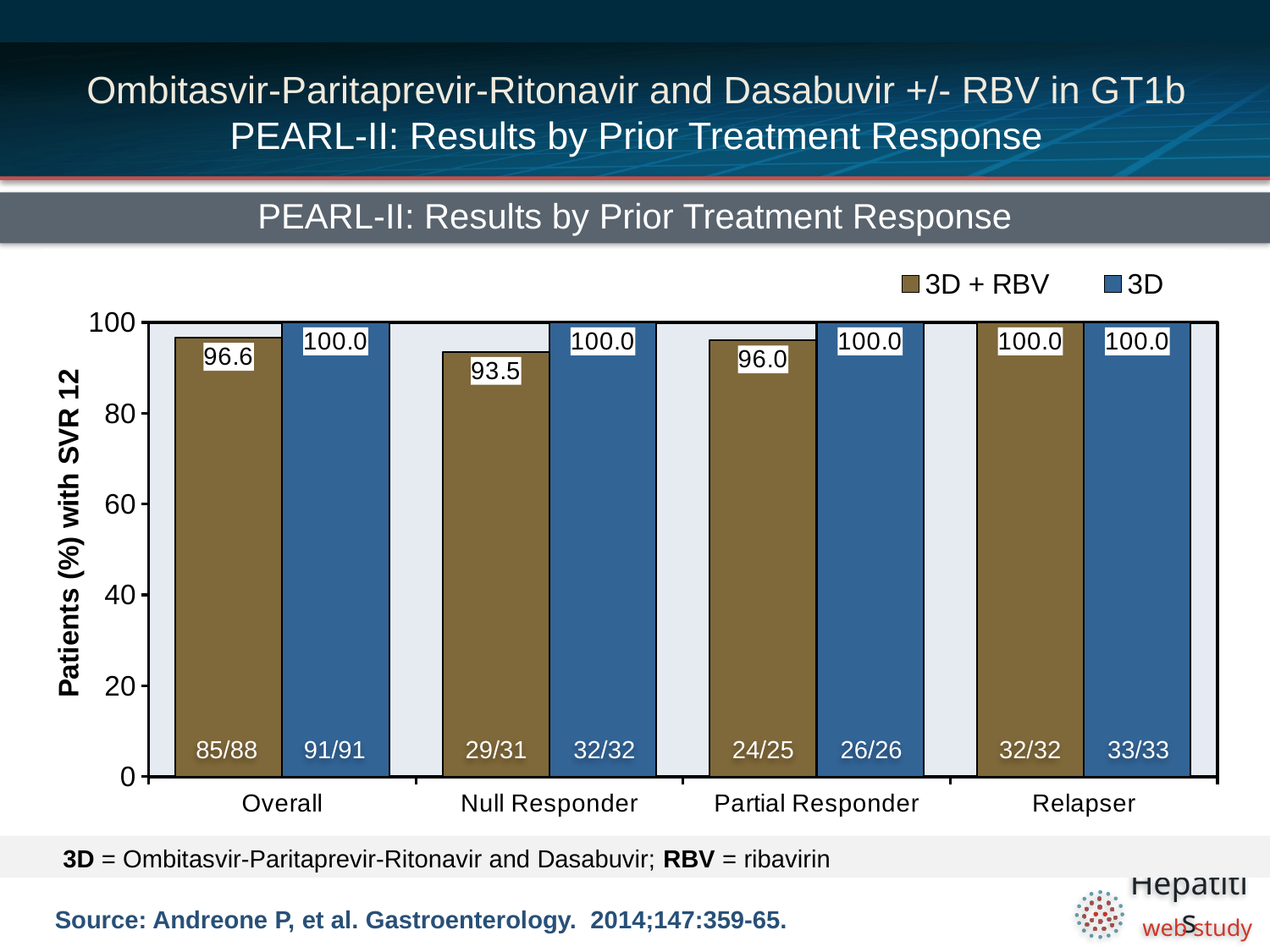
Which prior treatment response category has the lowest SVR 12 rate for the 3D + RBV group? Null Responder What type of chart is shown on the slide? Bar chart What is the difference between the 3D and 3D + RBV SVR 12 rates in the Overall category? 3.4 What is the difference between the 3D and 3D + RBV SVR 12 rates among Null Responders? 6.5 How many series does the legend list? 2 What is the SVR 12 rate for the 3D group among Partial Responders? 100.0 How many prior treatment response categories are shown on the x axis? 4 What is the SVR 12 rate for the 3D + RBV group in the Overall category? 96.6 Among Partial Responders, which group has the higher SVR 12 rate, 3D + RBV or 3D? 3D What is the SVR 12 rate for the 3D + RBV group among Null Responders? 93.5 What is the label of the y axis? Patients (%) with SVR 12 What is the SVR 12 rate for the 3D + RBV group among Relapsers? 100.0